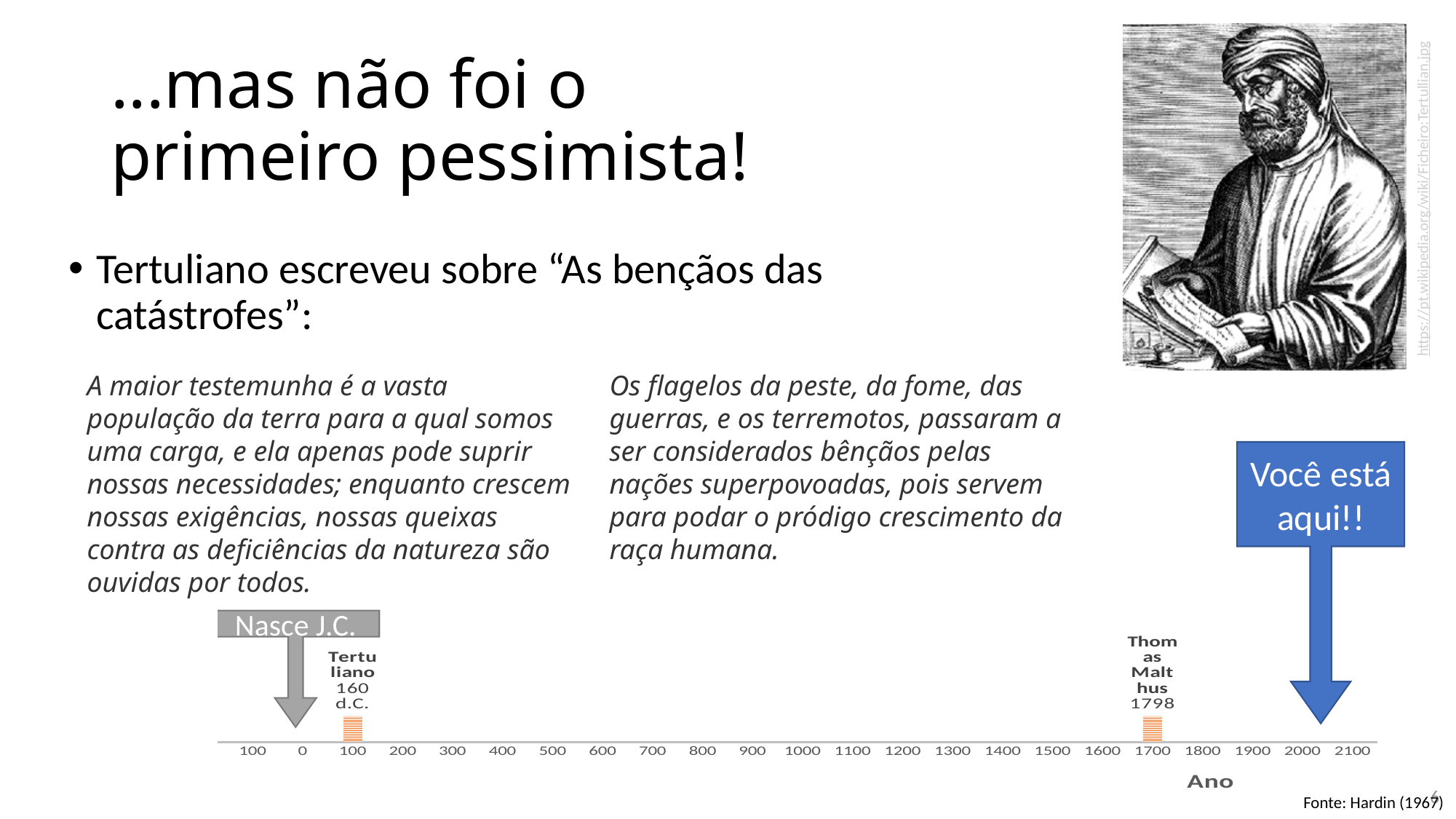
According to the label on the timeline chart, in what year is Tertuliano placed? 160 d.C. Which labelled bar on the timeline chart is placed at the earliest year? Tertuliano What does the grey arrow labelled 'Nasce J.C.' point to on the x axis of the timeline chart? 0 How many years separate the Tertuliano label (160 d.C.) and the Thomas Malthus label (1798) on the timeline chart? 1638 How many bars are plotted on the timeline chart at the bottom of the slide? 2 What is the title of the x axis of the timeline chart? Ano What is the last tick value shown on the x axis of the timeline chart? 2100 What kind of chart is shown at the bottom of the slide? bar chart According to the label on the timeline chart, in what year is Thomas Malthus placed? 1798 Is the year of the Tertuliano bar on the timeline chart greater or less than 200? less Which of the two labelled bars on the timeline chart is placed at the later year, Tertuliano or Thomas Malthus? Thomas Malthus